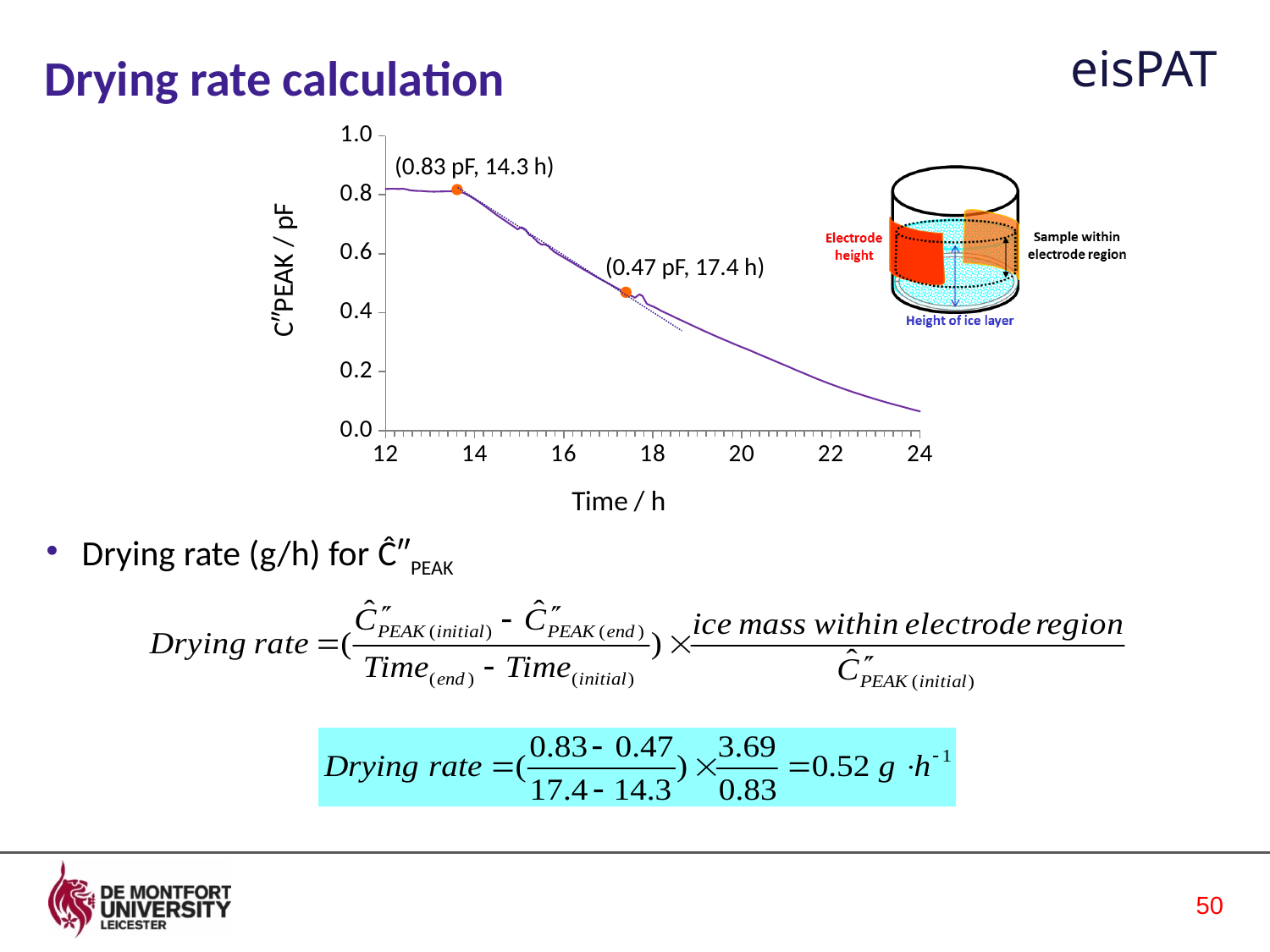
What is the C''PEAK value at the labelled point at 17.4 h? 0.47 pF Which of the two labelled points has the higher C''PEAK value, the one at 14.3 h or the one at 17.4 h? 14.3 h Does C''PEAK rise or fall as time increases along the x axis? fall Is the C''PEAK value at 16 h greater or less than 0.4? greater What is the title of the x axis of the chart? Time / h What is the difference in C''PEAK between the two labelled points on the chart? 0.36 pF What kind of chart is shown on the slide? line chart At what time does the labelled point with 0.83 pF occur? 14.3 h Is the C''PEAK value at 24 h greater or less than 0.2? less What is the C''PEAK value at the first labelled point on the chart? 0.83 pF At what time does the second labelled point on the chart occur? 17.4 h How many hours separate the two labelled points on the chart? 3.1 h